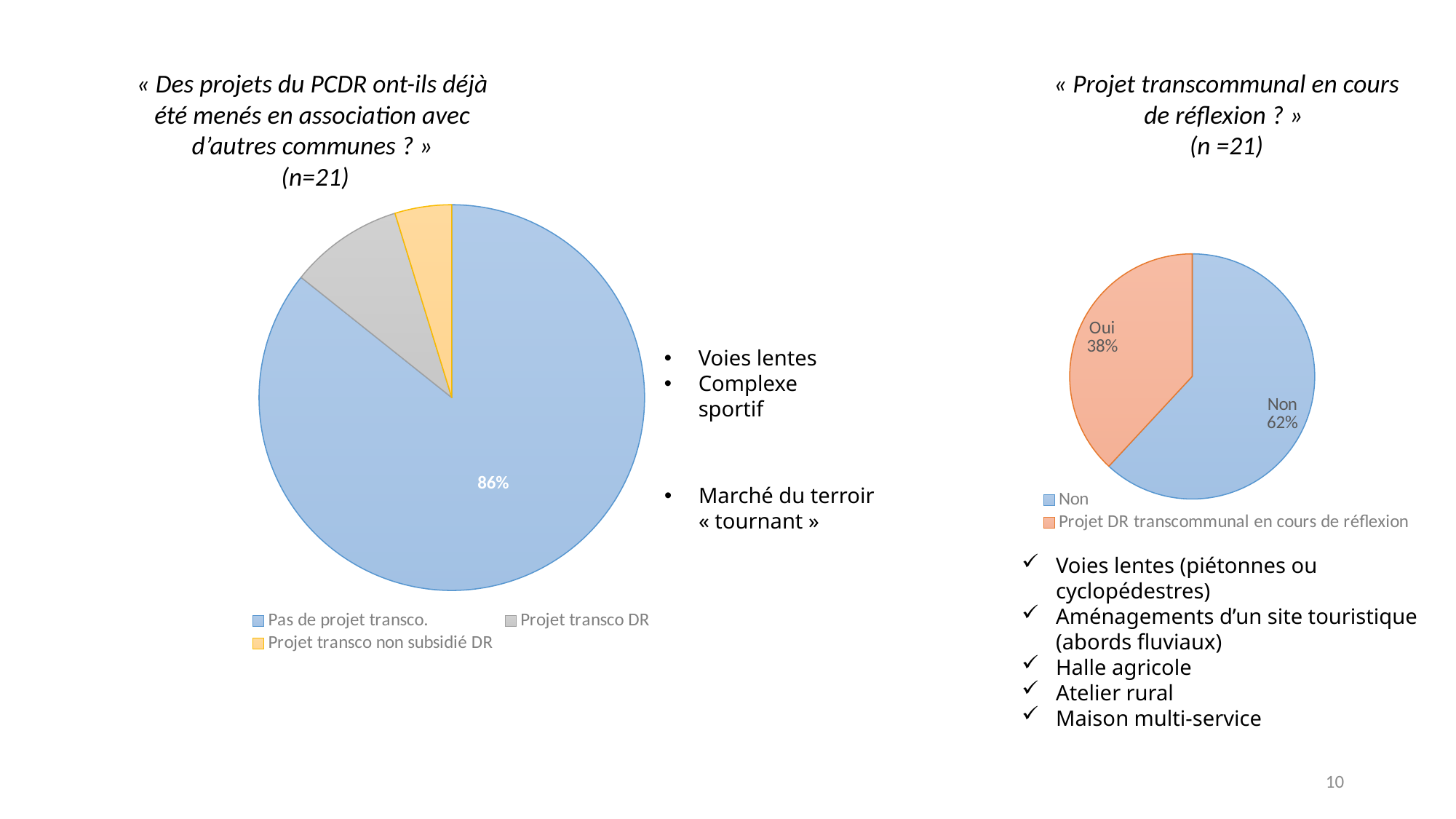
What sample size (n) is stated in the title of the right pie chart? 21 In the right pie chart ("Projet transcommunal en cours de réflexion ?"), what percentage is shown for "Non"? 62% In the left pie chart, which category has the largest slice? Pas de projet transco. How many categories does the legend of the left pie chart list? 3 In the right pie chart, which answer has the larger share, Oui or Non? Non In the right pie chart, what is the difference in percentage points between the Non and Oui shares? 24 percentage points In the left pie chart, which category has the smallest slice? Projet transco non subsidié DR In the left pie chart, which category is shown in grey? Projet transco DR In the right pie chart ("Projet transcommunal en cours de réflexion ?"), what percentage is shown for "Oui"? 38% What type of chart is used on the left side of the slide? Pie chart In the left pie chart ("Des projets du PCDR ont-ils déjà été menés en association avec d'autres communes ?"), what share is labelled for "Pas de projet transco."? 86% How many slices does the right pie chart have? 2